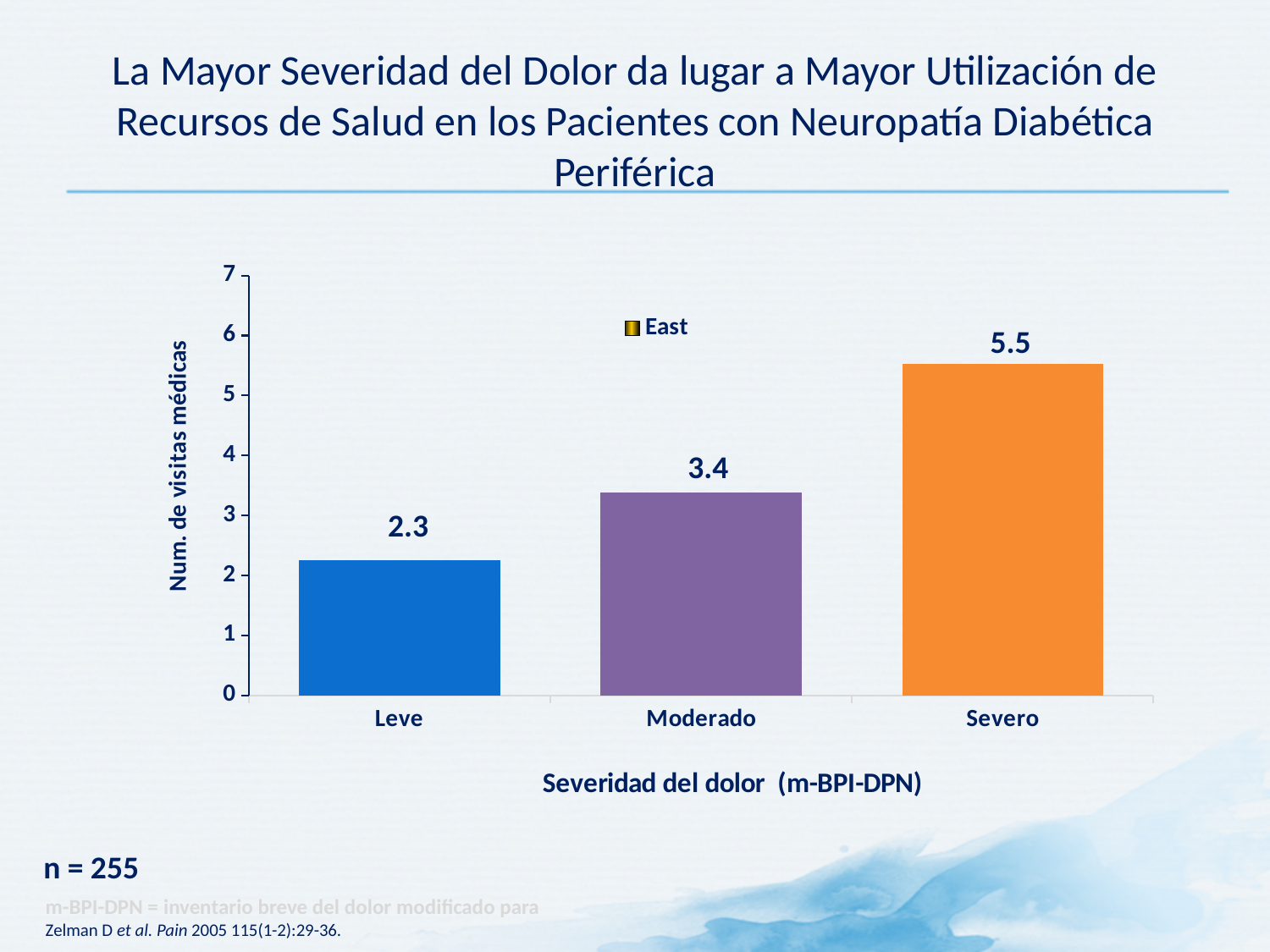
What is the label on the y axis of the chart? Num. de visitas médicas Which pain severity category has the highest number of medical visits? Severo What is the difference in medical visits between the Severo and Leve categories? 3.2 What kind of chart is shown on the slide? Bar chart What is the number of medical visits for the Leve category? 2.3 What is the number of medical visits for the Severo category? 5.5 Do the values rise or fall as pain severity increases from Leve to Severo? Rise How many pain severity categories are shown on the x axis? 3 What is the difference in medical visits between the Moderado and Leve categories? 1.1 Which has more medical visits, Moderado or Severo? Severo Which pain severity category has the lowest number of medical visits? Leve What is the number of medical visits for the Moderado category? 3.4